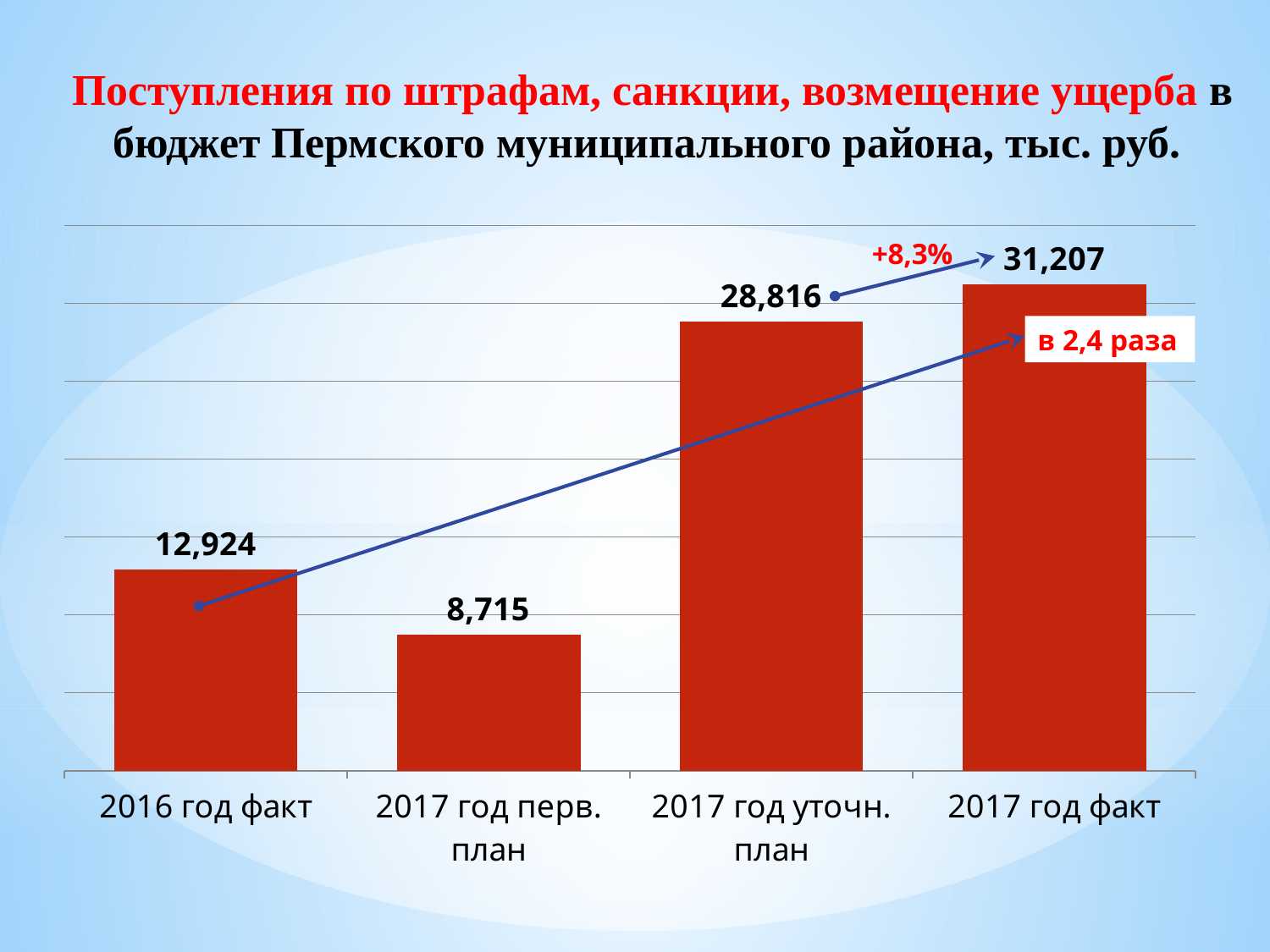
Which category has the lowest value? 2017 год перв. план What is the difference between the values for 2017 год факт and 2017 год уточн. план? 2,391 What is the difference between the values for 2016 год факт and 2017 год перв. план? 4,209 What kind of chart is shown on the slide? bar chart How many categories are shown on the x axis? 4 What percentage change is annotated between 2017 год уточн. план and 2017 год факт? +8,3% What is the value for 2017 год факт? 31,207 What is the value for 2017 год уточн. план? 28,816 Which is larger, the value for 2016 год факт or the value for 2017 год перв. план? 2016 год факт What is the value for 2017 год перв. план? 8,715 What is the value for 2016 год факт? 12,924 Which category has the highest value? 2017 год факт